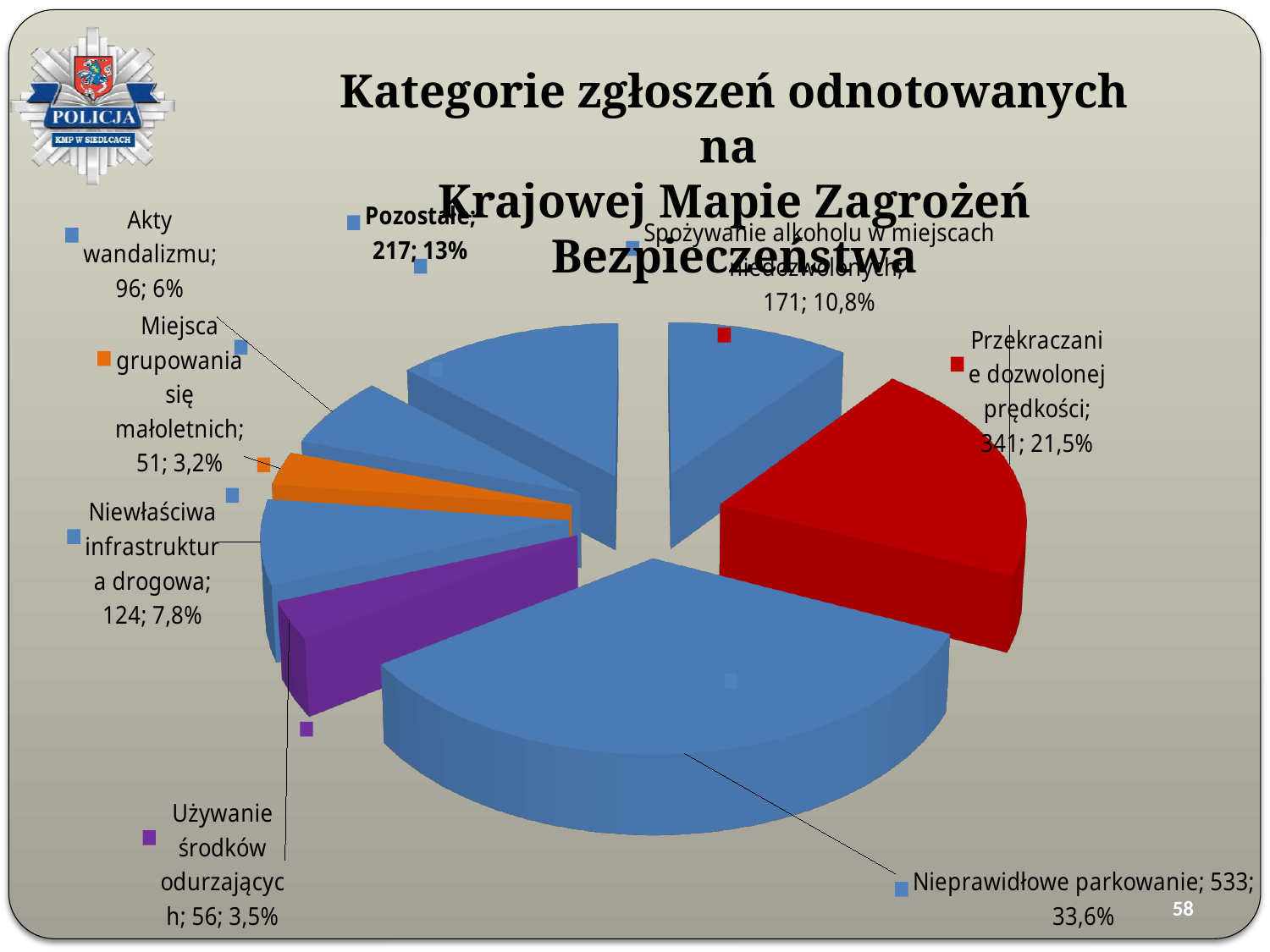
What is the difference between the values for Nieprawidłowe parkowanie and Przekraczanie dozwolonej prędkości? 192 What is the value for Nieprawidłowe parkowanie? 533 What is the value for Spożywanie alkoholu w miejscach niedozwolonych? 171 Which category has the smallest slice of the pie? Miejsca grupowania się małoletnich What share of the pie does Akty wandalizmu represent? 6% What type of chart is shown on the slide? pie chart What share of the pie does Przekraczanie dozwolonej prędkości represent? 21,5% How many categories does the pie chart show? 8 Which is larger, the value for Niewłaściwa infrastruktura drogowa or the value for Akty wandalizmu? Niewłaściwa infrastruktura drogowa Which category has the largest slice of the pie? Nieprawidłowe parkowanie What is the title of the chart? Kategorie zgłoszeń odnotowanych na Krajowej Mapie Zagrożeń Bezpieczeństwa What is the value for Używanie środków odurzających? 56